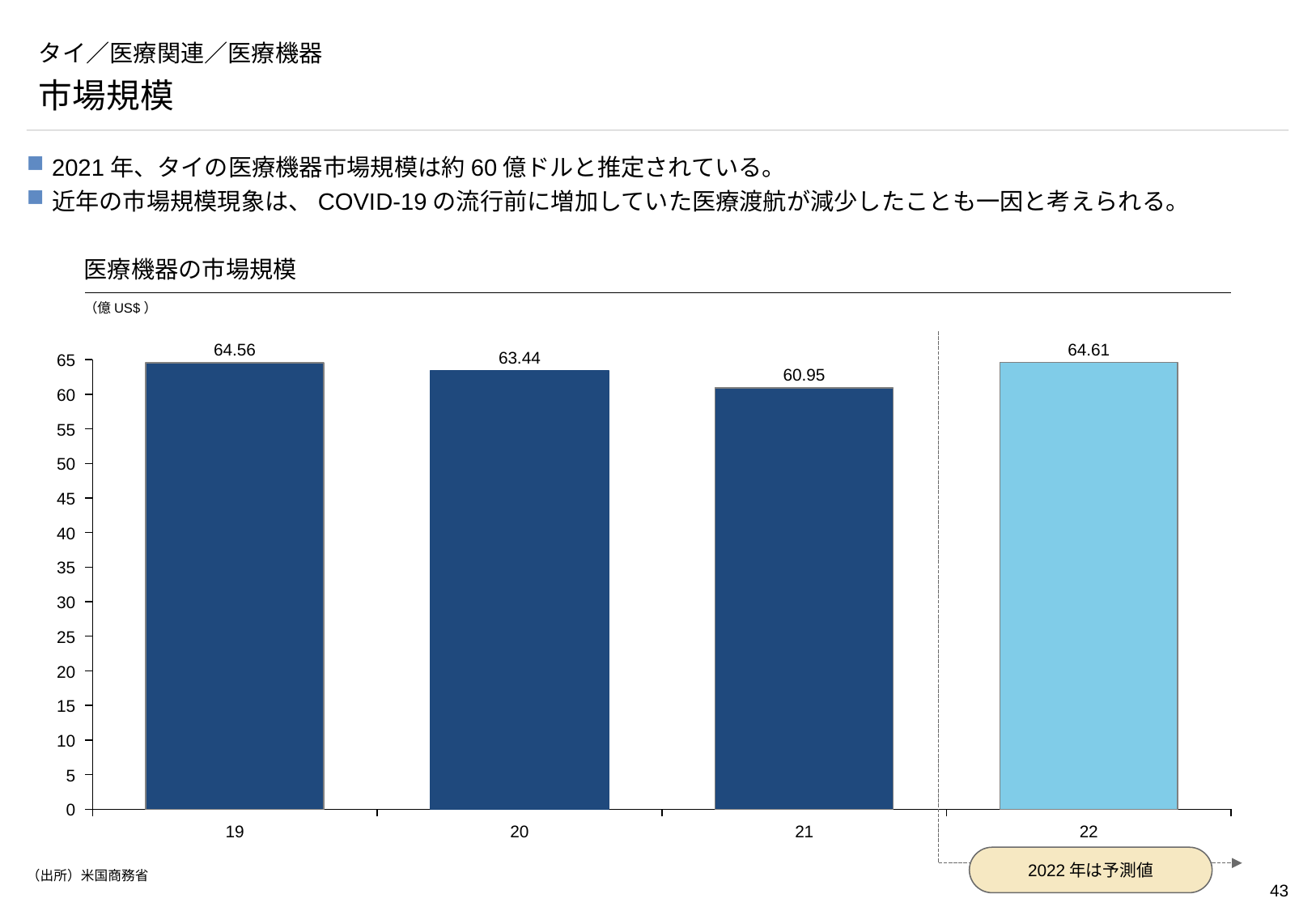
What is the difference between the values for 20 and 21? 2.49 What kind of chart is shown on the slide? bar chart What is the value for 21 in the chart? 60.95 Do the values rise or fall from 19 to 21? fall How many bars are plotted in the chart? 4 What is the value for 20 in the chart? 63.44 What is the value for 22 in the chart? 64.61 Which is larger, the value for 20 or the value for 21? 20 What is the value for 19 in the 医療機器の市場規模 chart? 64.56 Which year has the lowest value in the chart? 21 What is the difference between the values for 19 and 21? 3.61 Is the value for 21 greater or less than 55? greater